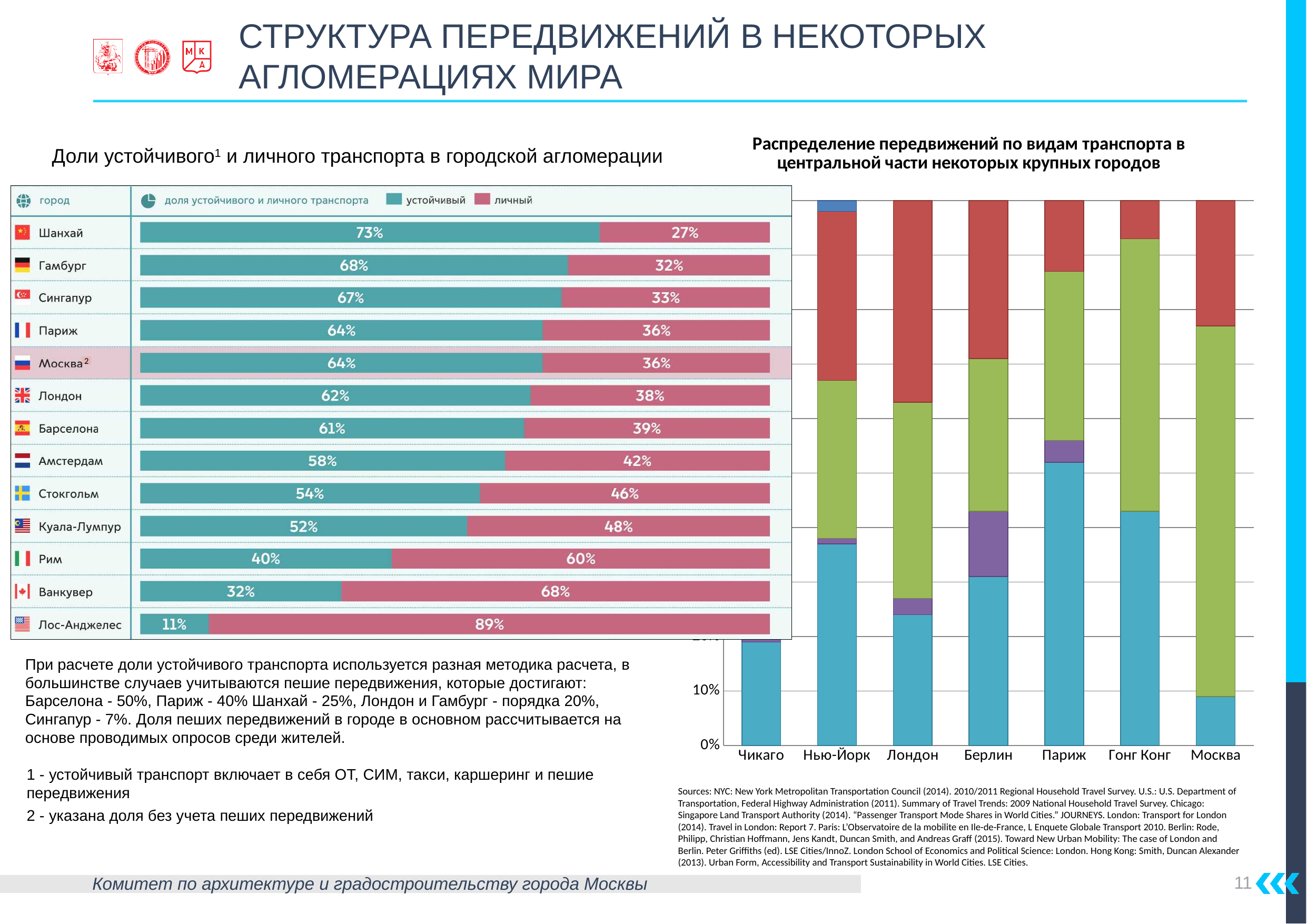
In the left chart (Доли устойчивого и личного транспорта), what is the share of sustainable transport (устойчивый) for Шанхай? 73% In the left chart (Доли устойчивого и личного транспорта), how many series does the legend list? 2 In the left chart (Доли устойчивого и личного транспорта), which city has the highest share of sustainable transport? Шанхай In the left chart (Доли устойчивого и личного транспорта), what is the total of the two segments for Стокгольм? 100% What kind of chart is the right chart (Распределение передвижений по видам транспорта)? Stacked bar chart In the left chart (Доли устойчивого и личного транспорта), what is the difference between the sustainable transport shares of Шанхай and Гамбург? 5% In the left chart (Доли устойчивого и личного транспорта), which city has the lowest share of sustainable transport? Лос-Анджелес In the left chart (Доли устойчивого и личного транспорта), what is the share of personal transport (личный) for Лос-Анджелес? 89% In the left chart (Доли устойчивого и личного транспорта), what is the share of sustainable transport for Москва? 64% In the left chart (Доли устойчивого и личного транспорта), how many cities are listed? 13 In the right chart (Распределение передвижений по видам транспорта), how many cities are shown on the x axis? 7 In the left chart (Доли устойчивого и личного транспорта), which city has a larger share of sustainable transport, Рим or Ванкувер? Рим